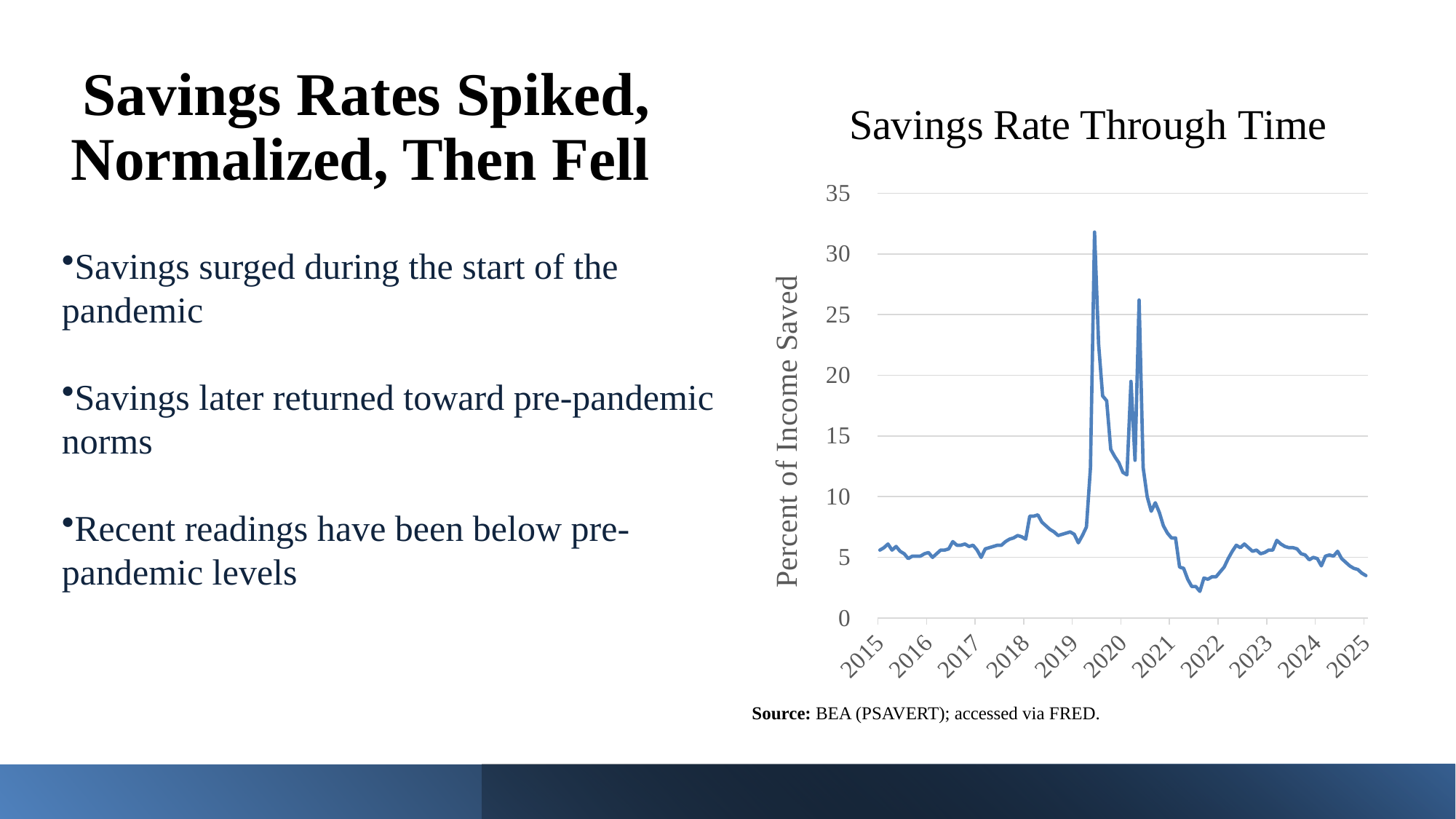
From the 2020 peak to 2022, does the savings rate rise or fall? fall Is the value at the start of 2015 greater or less than 10? less Is the value at the start of 2018 greater or less than 10? less Is the lowest value on the chart greater or less than 5? less In which year does the savings rate reach its highest point? 2020 What kind of chart is shown on the slide? line chart What is the label on the vertical axis of the chart? Percent of Income Saved How many year labels are shown on the horizontal axis? 11 What is the title of the chart? Savings Rate Through Time